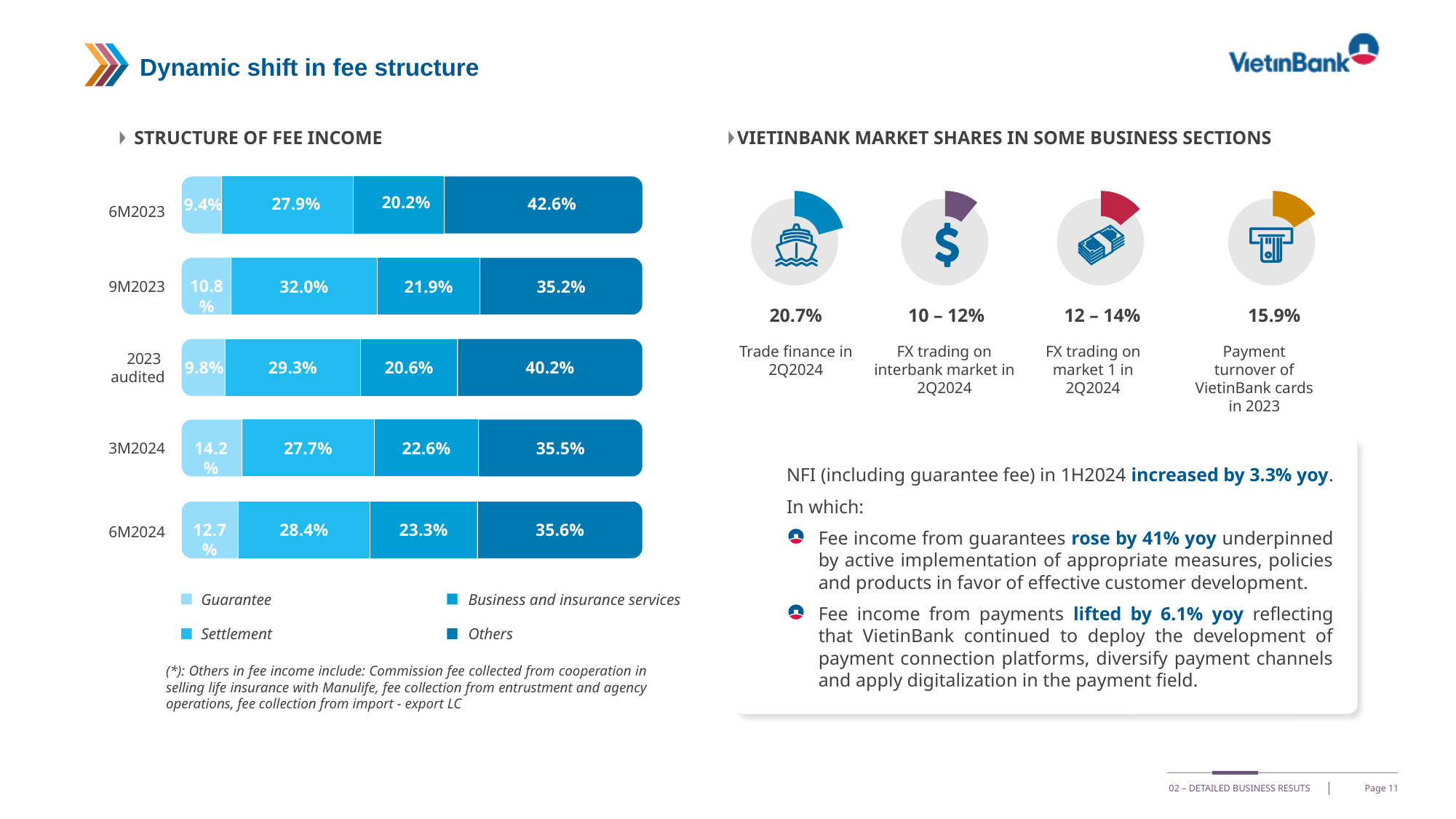
In the Structure of Fee Income chart, what is the Business and insurance services share in 6M2024? 23.3% In the Structure of Fee Income chart, is the Settlement share larger in 9M2023 or in 6M2024? 9M2023 In the Structure of Fee Income chart, what share does Others account for in 6M2023? 42.6% In the Structure of Fee Income chart, which period has the highest Others share? 6M2023 In the Structure of Fee Income chart, which period has the lowest Guarantee share? 6M2023 In the Structure of Fee Income chart, which period has the highest Guarantee share? 3M2024 What type of chart is the Structure of Fee Income chart? Stacked bar chart In the Structure of Fee Income chart, what is the Settlement share in 9M2023? 32.0% In the Structure of Fee Income chart, what is the Guarantee share in 3M2024? 14.2% How many periods are shown in the Structure of Fee Income chart? 5 In the Structure of Fee Income chart, by how many percentage points is the Others share in 6M2023 higher than in 6M2024? 7.0 percentage points How many series does the legend of the Structure of Fee Income chart list? 4